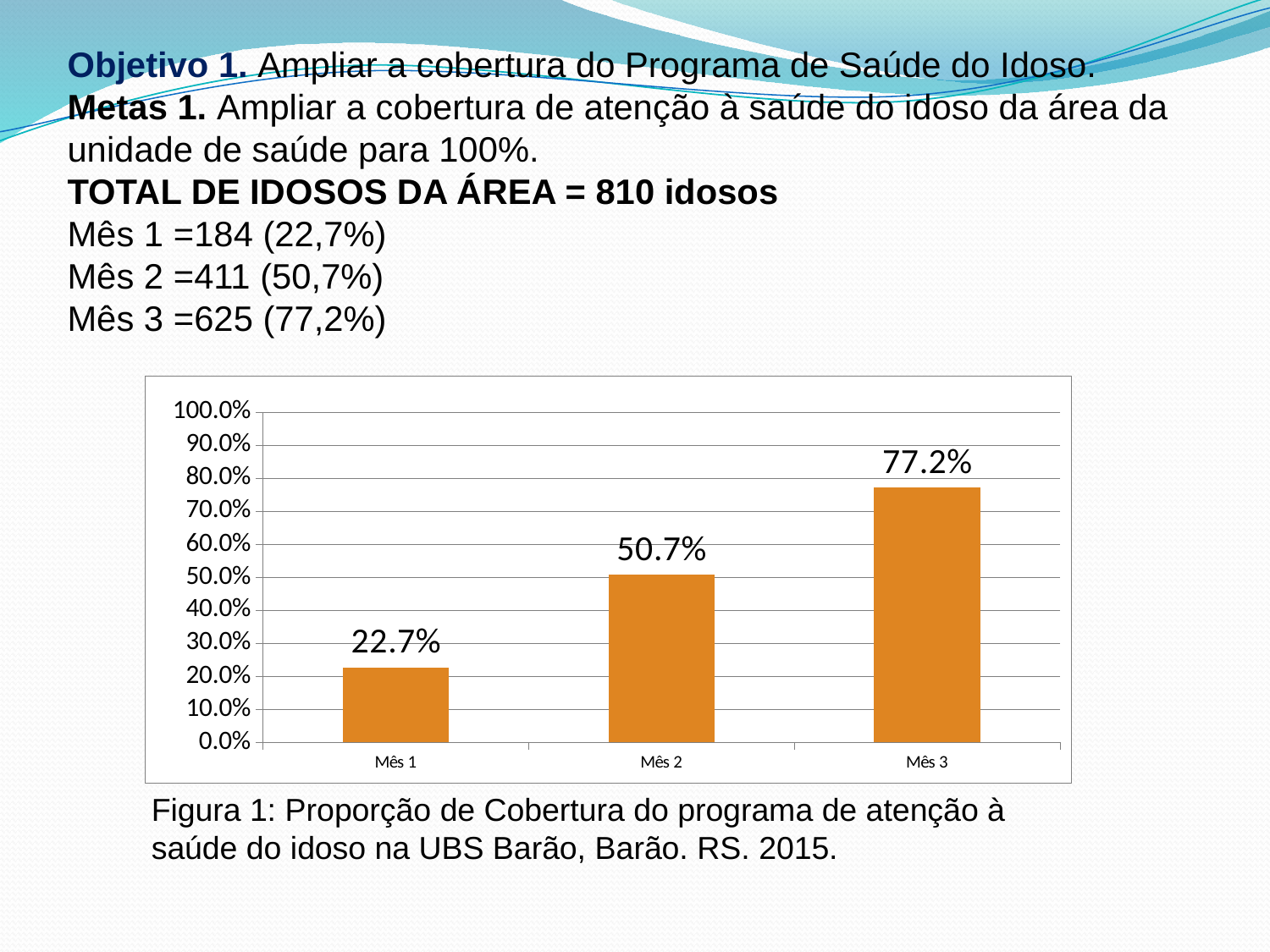
How many categories are shown on the x axis? 3 Which month has the lowest value? Mês 1 Which month has the highest value? Mês 3 What is the value for Mês 3? 77.2% What is the value for Mês 1? 22.7% Do the values rise or fall from Mês 1 to Mês 3? rise What is the difference between the values for Mês 2 and Mês 1? 28.0% What is the value for Mês 2? 50.7% Which is larger, the value for Mês 2 or the value for Mês 3? Mês 3 What is the difference between the values for Mês 3 and Mês 1? 54.5% Is the value for Mês 2 greater or less than 40.0%? greater What kind of chart is shown on the slide? bar chart